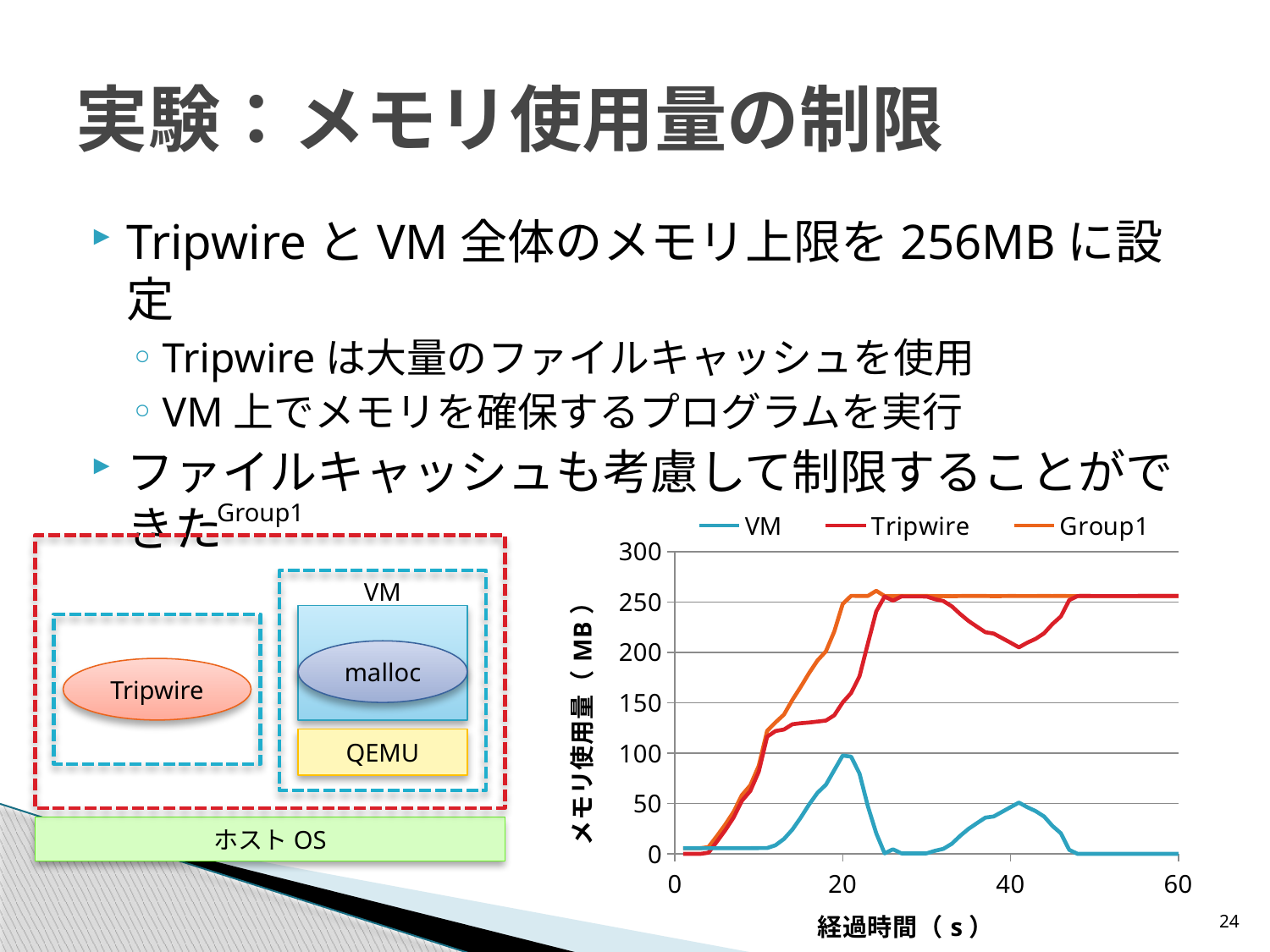
Is the value of the Group1 series at 15 s greater or less than 150? greater At 20 s, which series has the larger value, Group1 or Tripwire? Group1 What are the series names listed in the chart legend? VM, Tripwire, Group1 Is the value of the VM series at 10 s greater or less than 50? less What kind of chart is shown on the slide? line chart Does the Tripwire series rise or fall between 0 s and 25 s? rise At 40 s, which series has the larger value, Tripwire or VM? Tripwire How many series does the chart legend list? 3 What is the title of the chart's vertical axis? メモリ使用量（MB） Is the value of the VM series at 60 s greater or less than 50? less